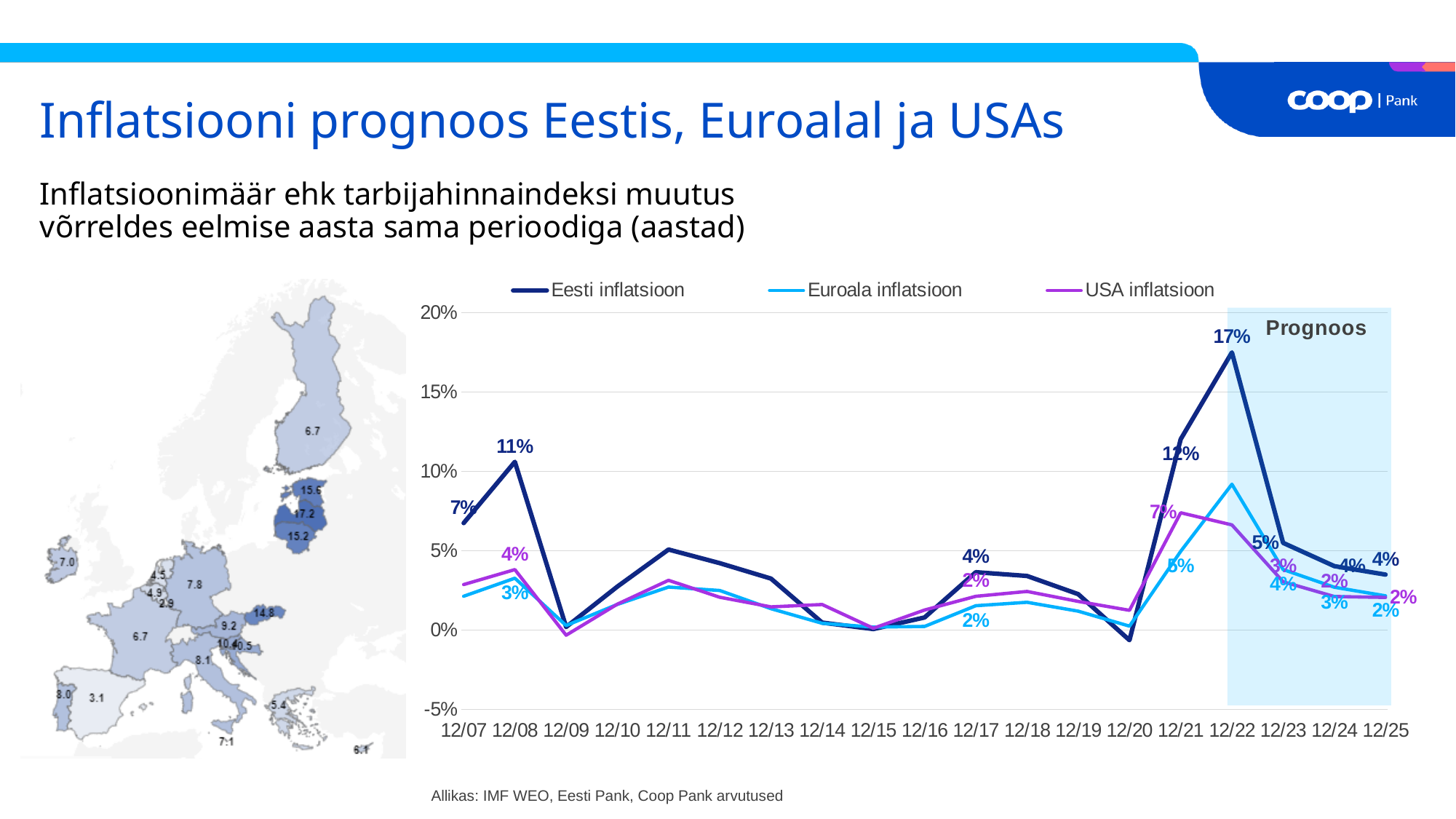
Does Eesti inflatsioon rise or fall from 12/22 to 12/25? fall How many series does the chart legend list? 3 What label is shown on the shaded area at the right of the chart? Prognoos What kind of chart is shown on the slide? line chart What is the difference between Eesti inflatsioon at 12/22 and at 12/21? 5 percentage points How many dates are shown on the x axis? 19 What is the value of Eesti inflatsioon at 12/22? 17% Is the value of Eesti inflatsioon at 12/22 greater or less than 15%? greater What is the value of Eesti inflatsioon at 12/08? 11% At which date does Eesti inflatsioon reach its highest value? 12/22 What is the value of Euroala inflatsioon at 12/25? 2% At 12/21, which is higher: USA inflatsioon or Euroala inflatsioon? USA inflatsioon